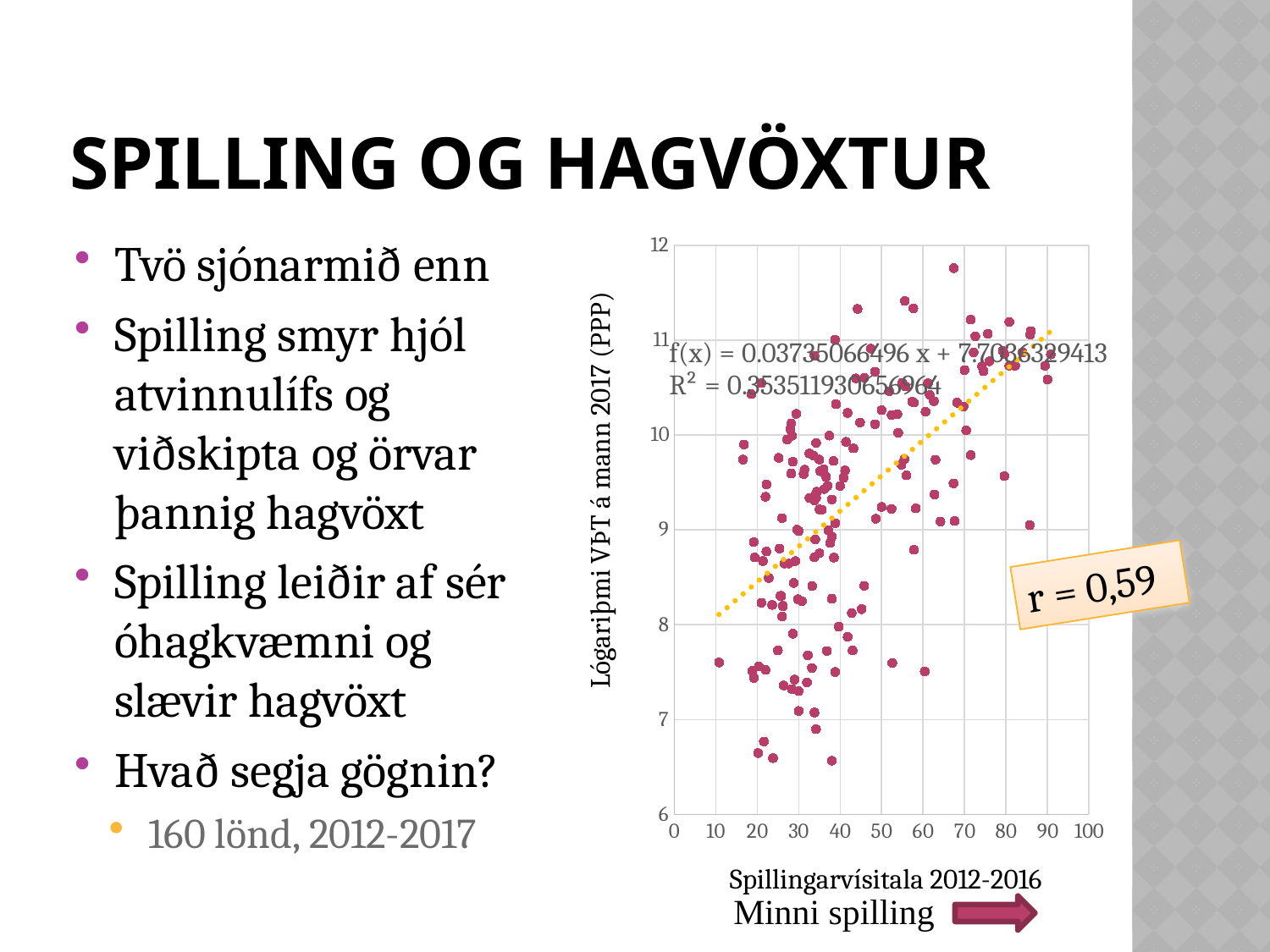
What is the minimum value shown on the y axis of the chart? 6 Is the lowest plotted point on the chart greater or less than 7 on the y axis? less Is the highest plotted point on the chart greater or less than 11 on the y axis? greater What correlation coefficient r is shown in the callout on the chart? r = 0,59 What is the label of the x axis of the chart? Spillingarvísitala 2012-2016 What is the maximum value shown on the x axis of the chart? 100 What kind of chart is shown on the slide? scatter plot Are the plotted points at x = 90 greater or less than 10 on the y axis? greater What is the maximum value shown on the y axis of the chart? 12 Do the plotted values generally rise or fall as the Spillingarvísitala increases along the x axis? rise Does the chart include a fitted trendline through the points? yes